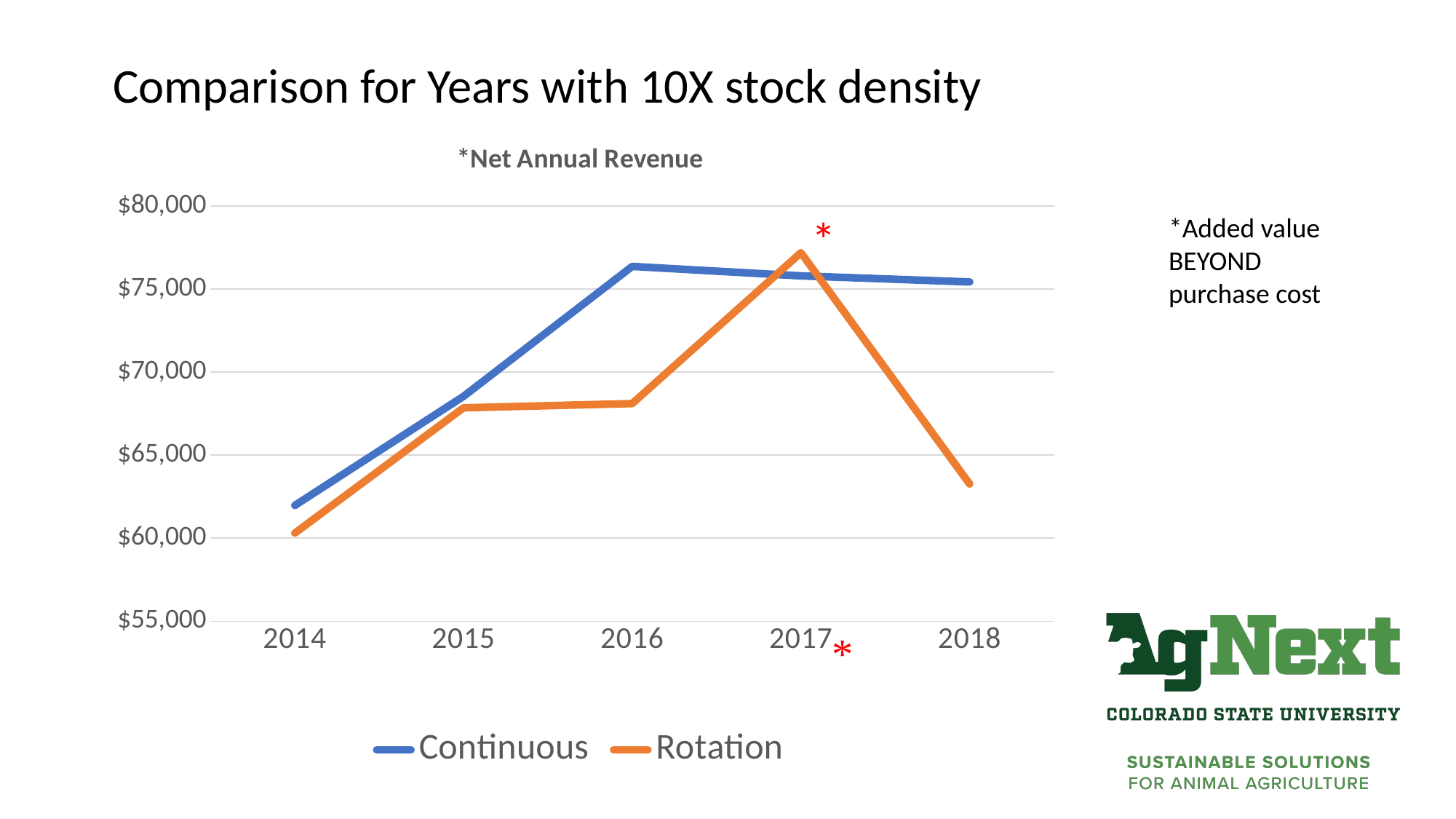
How many series does the legend list? 2 In which year is the Continuous series at its lowest value? 2014 Which series is drawn in orange? Rotation Is the value for Continuous in 2016 greater or less than $75,000? greater Which series has the higher value in 2018, Continuous or Rotation? Continuous Is the value for Rotation in 2018 greater or less than $65,000? less Which series has the higher value in 2017, Continuous or Rotation? Rotation How many years are plotted along the x axis? 5 Does the Rotation series rise or fall from 2017 to 2018? fall What kind of chart is shown on the slide? line chart In which year does the Rotation series reach its highest value? 2017 What is the title of the chart? *Net Annual Revenue